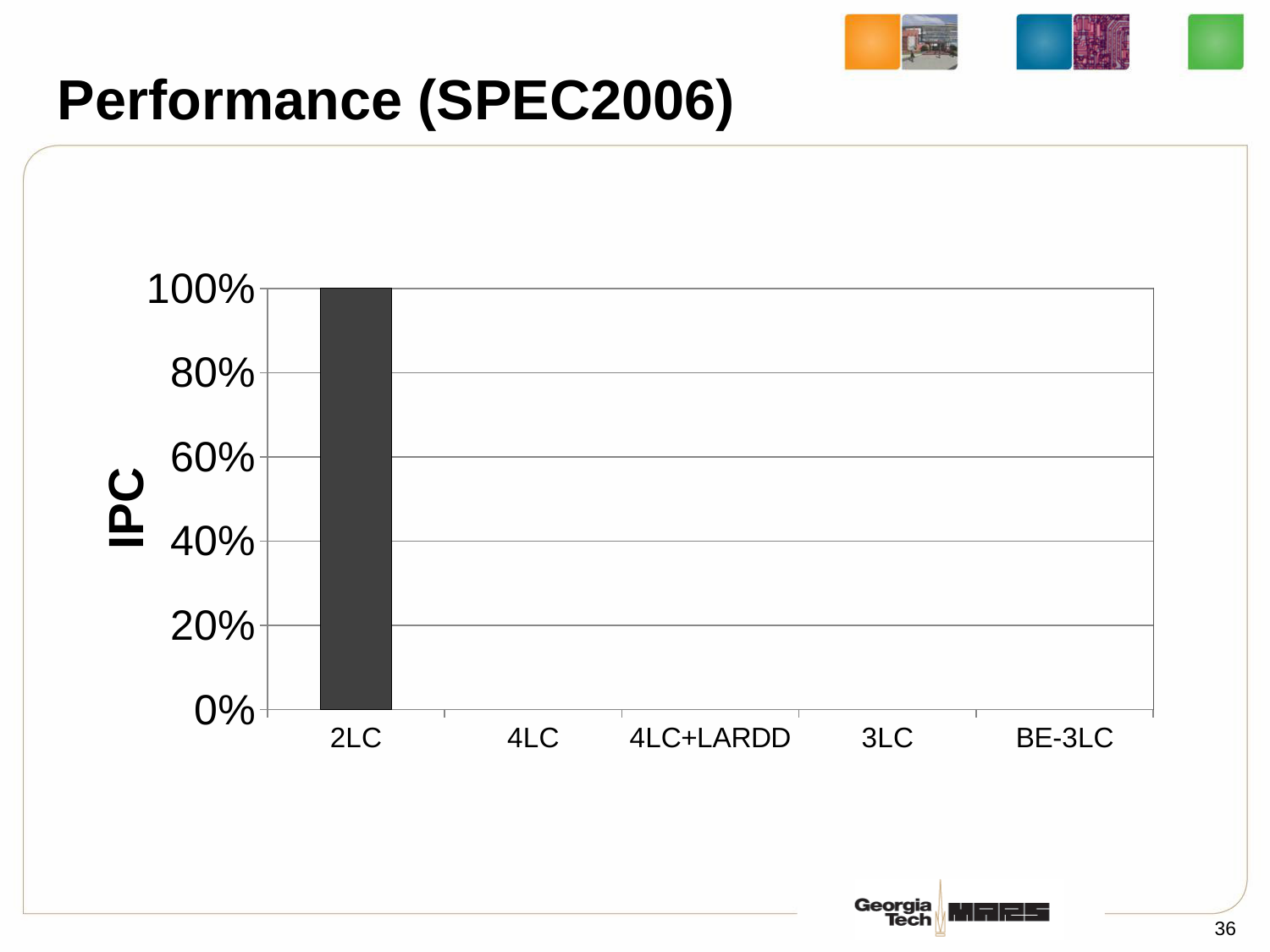
What kind of chart is shown on the slide? bar chart Is the value for 2LC greater or less than 80%? greater What is the label on the y axis of the chart? IPC How many categories are listed along the x axis of the chart? 5 Which category has the highest bar in the chart? 2LC What is the label of the last category on the x axis? BE-3LC What is the label of the first category on the x axis? 2LC What is the highest value shown on the y axis of the chart? 100% What is the IPC value shown for 2LC? 100%